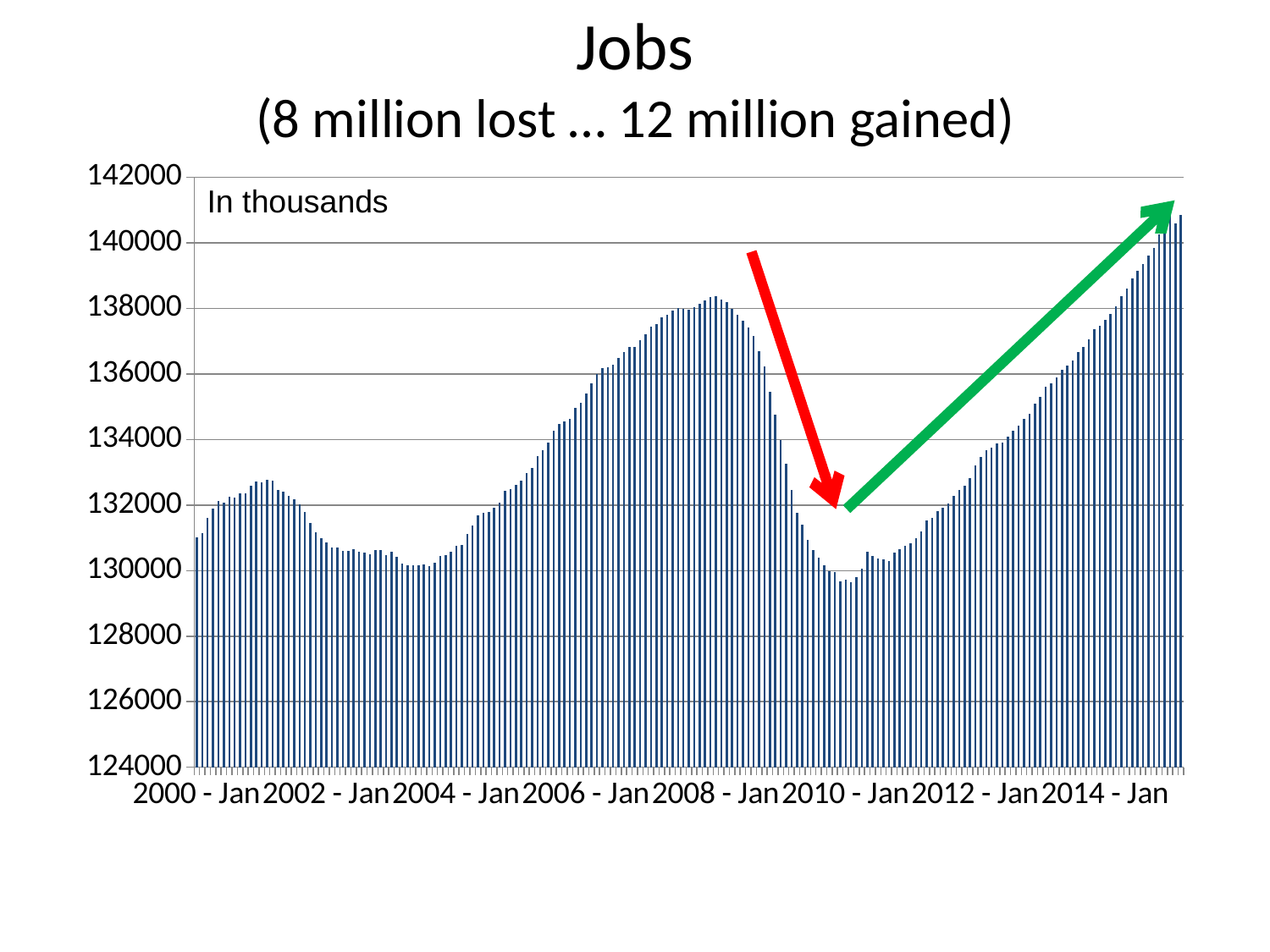
Which is larger, the value for 2008 - Jan or the value for 2010 - Jan? 2008 - Jan Is the value for 2014 - Jan greater or less than 136000? greater Is the value for 2000 - Jan greater or less than 130000? greater What kind of chart is shown on the slide? bar chart What is the title of the chart? Jobs (8 million lost … 12 million gained) Which is larger, the value for 2000 - Jan or the value for 2014 - Jan? 2014 - Jan In what units are the values plotted, according to the note inside the chart? In thousands Do the values rise or fall between 2010 - Jan and 2014 - Jan? rise Is the value for 2004 - Jan greater or less than 132000? less Do the values rise or fall between 2008 - Jan and 2010 - Jan? fall